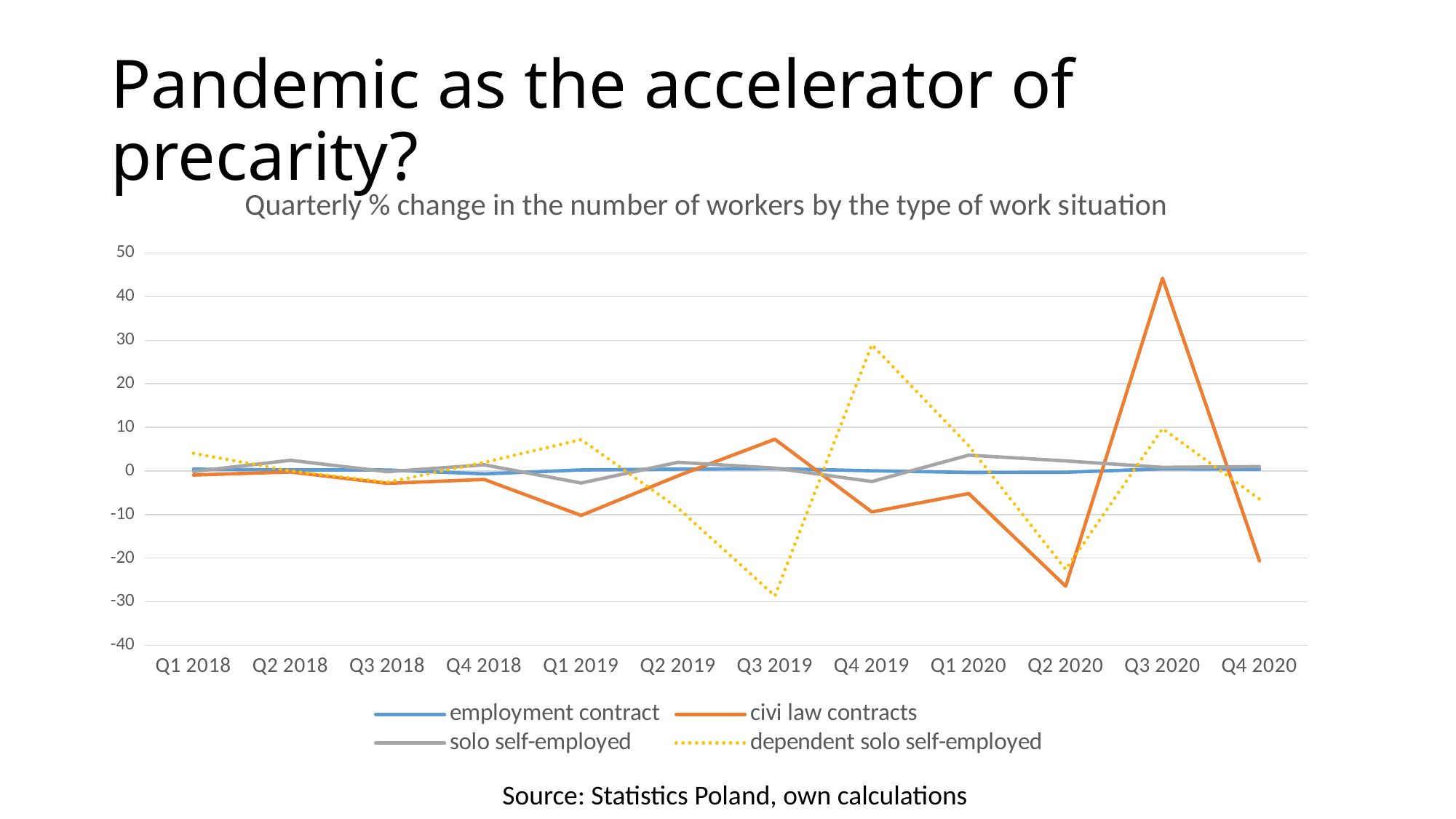
In which quarter does the civi law contracts series reach its highest value? Q3 2020 What kind of chart is shown on the slide? line chart Which series is drawn with a dotted line? dependent solo self-employed How many series does the legend list? 4 In Q3 2020, which series has the larger value: civi law contracts or dependent solo self-employed? civi law contracts In which quarter does the dependent solo self-employed series reach its lowest value? Q3 2019 In which quarter does the civi law contracts series reach its lowest value? Q2 2020 Is the value for civi law contracts in Q3 2020 greater or less than 40? greater Is the value for civi law contracts in Q2 2020 greater or less than -20? less Does the civi law contracts series rise or fall from Q3 2020 to Q4 2020? fall Is the value for dependent solo self-employed in Q4 2019 greater or less than 20? greater How many quarters are shown on the x axis? 12